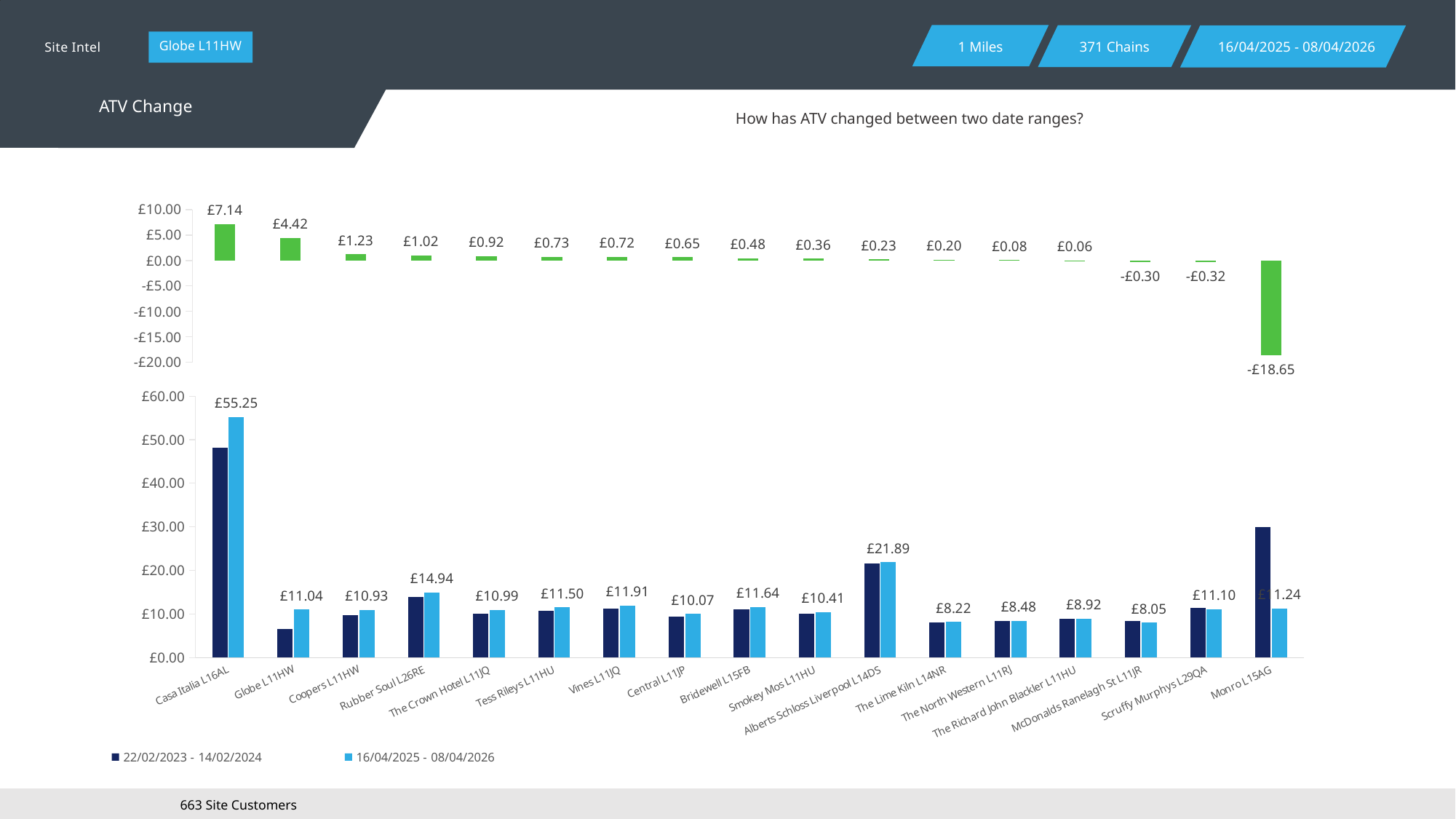
In the bottom chart, which category has the lowest labelled value in the 16/04/2025 - 08/04/2026 series? McDonalds Ranelagh St L11JR In the bottom chart, what is the value for Alberts Schloss Liverpool L14DS in the 16/04/2025 - 08/04/2026 series? £21.89 In the bottom chart, what is the value for Casa Italia L16AL in the 16/04/2025 - 08/04/2026 series? £55.25 In the top chart, what is the lowest value shown? -£18.65 How many series does the legend of the bottom chart list? 2 What kind of chart is the top chart? bar chart How many categories are shown on the x axis of the bottom chart? 17 In the bottom chart, is the value for Monro L15AG in the 22/02/2023 - 14/02/2024 series greater or less than £20.00? greater In the bottom chart, which has the larger 16/04/2025 - 08/04/2026 value: Vines L11JQ or Tess Rileys L11HU? Vines L11JQ In the bottom chart, which category has the highest value in the 16/04/2025 - 08/04/2026 series? Casa Italia L16AL In the bottom chart, what is the difference between the 16/04/2025 - 08/04/2026 values for Rubber Soul L26RE and Globe L11HW? £3.90 In the top chart, what is the highest value shown? £7.14